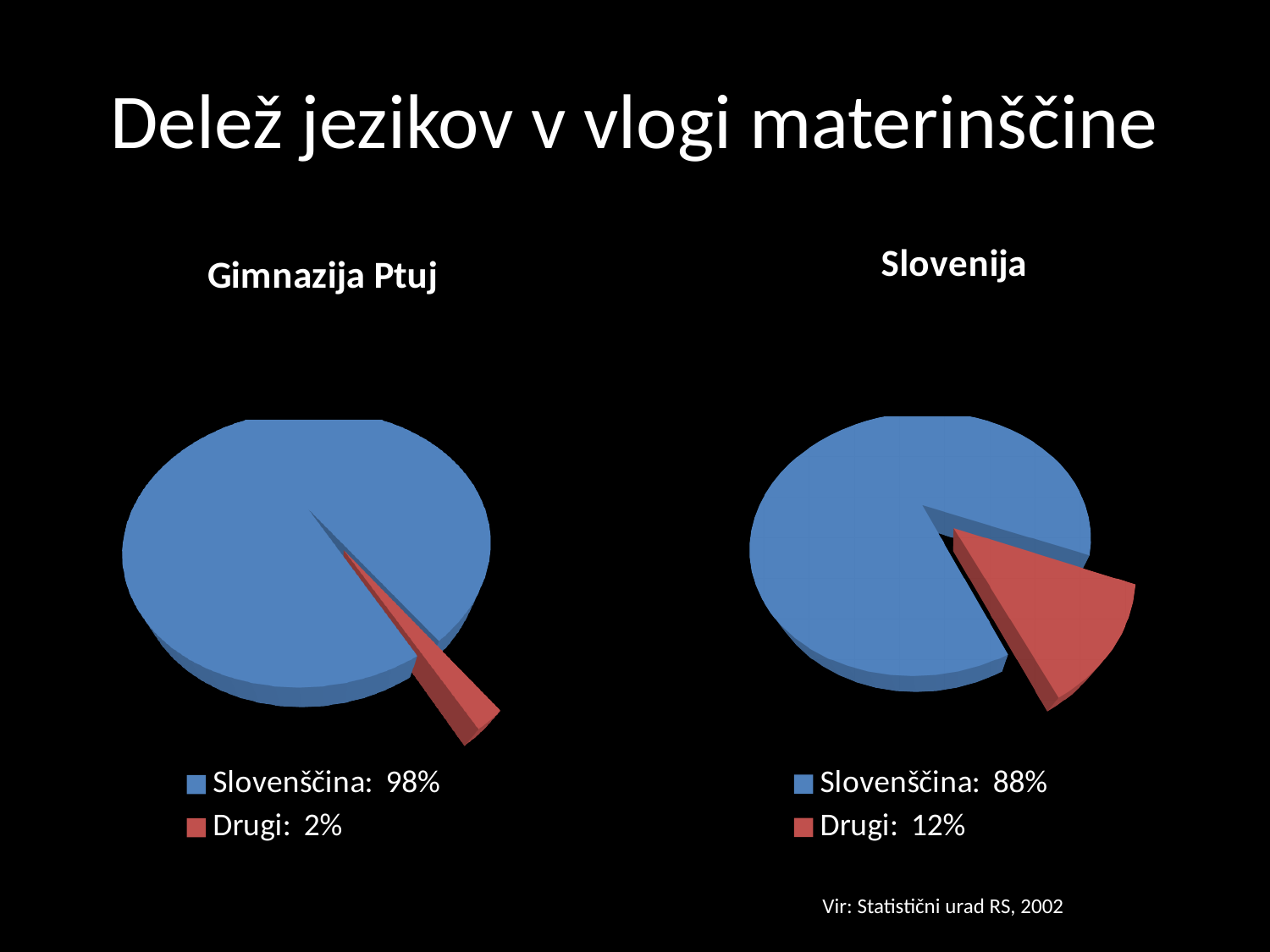
What is the difference between the Drugi share in the Slovenija chart and the Drugi share in the Gimnazija Ptuj chart? 10% In the Gimnazija Ptuj chart, which category has the smallest share? Drugi How many slices does the Slovenija pie chart have? 2 In the Slovenija chart, what share does Slovenščina have? 88% In the Slovenija chart, what colour is the Drugi slice? Red In the Gimnazija Ptuj chart, what share does Drugi have? 2% What kind of chart is the Gimnazija Ptuj chart? Pie chart What is the title of the slide containing the two pie charts? Delež jezikov v vlogi materinščine In the Slovenija chart, which category has the largest share? Slovenščina Which chart has the larger share for Drugi, Gimnazija Ptuj or Slovenija? Slovenija In the Slovenija chart, what share does Drugi have? 12%